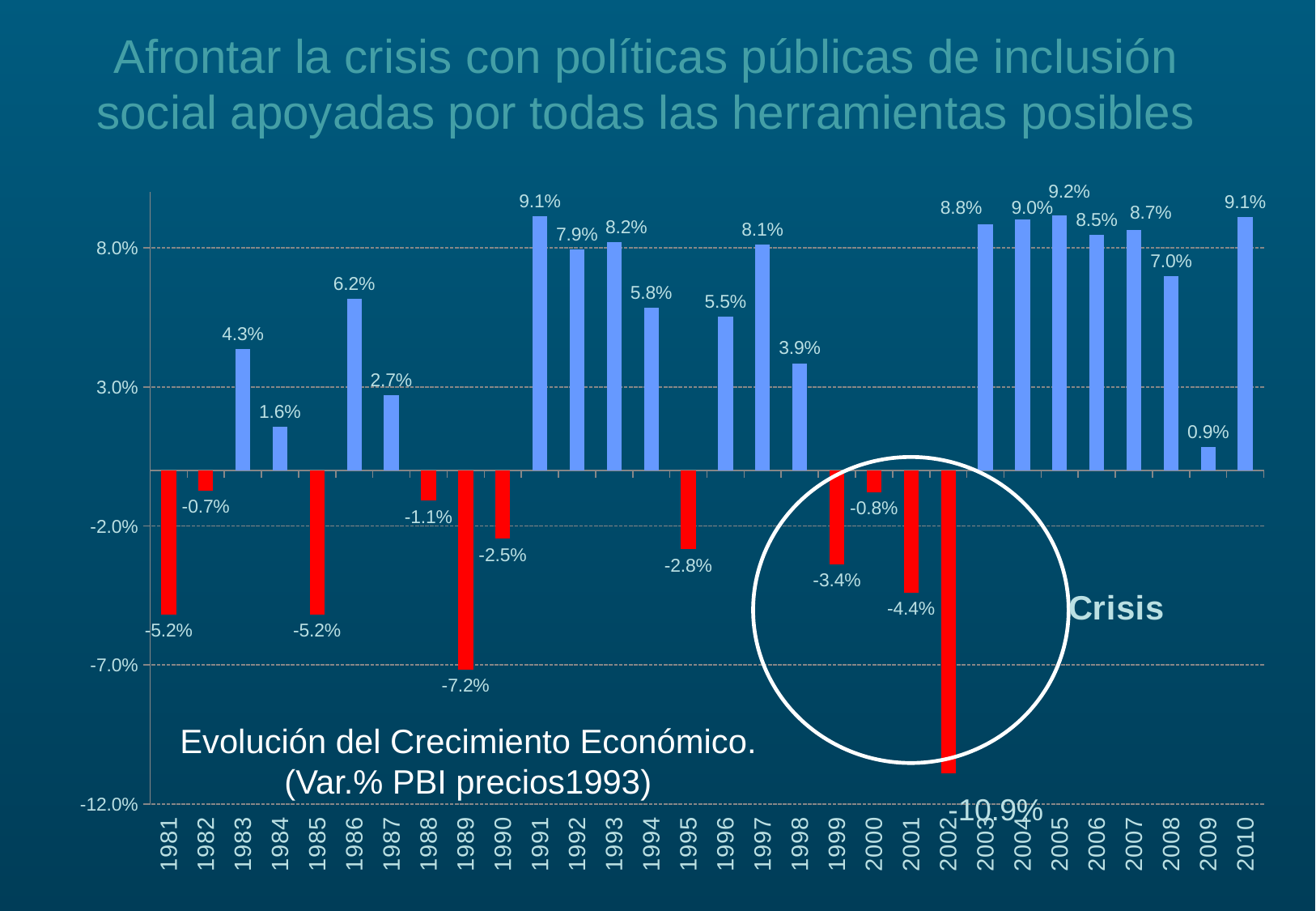
Which year has the lowest value? 2002 What is the value for 2002? -10.9% Which year has the highest value? 2005 What kind of chart is this? bar chart What is the value for 1989? -7.2% Which is larger, the value for 1986 or the value for 1994? 1986 What is the title of the chart? Evolución del Crecimiento Económico. (Var.% PBI precios1993) What is the value for 2009? 0.9% How many years are shown on the x axis? 30 What is the difference between the values for 2005 and 2008? 2.2% What is the value for 1991? 9.1% Is the value for 2003 greater or less than 8.0%? greater